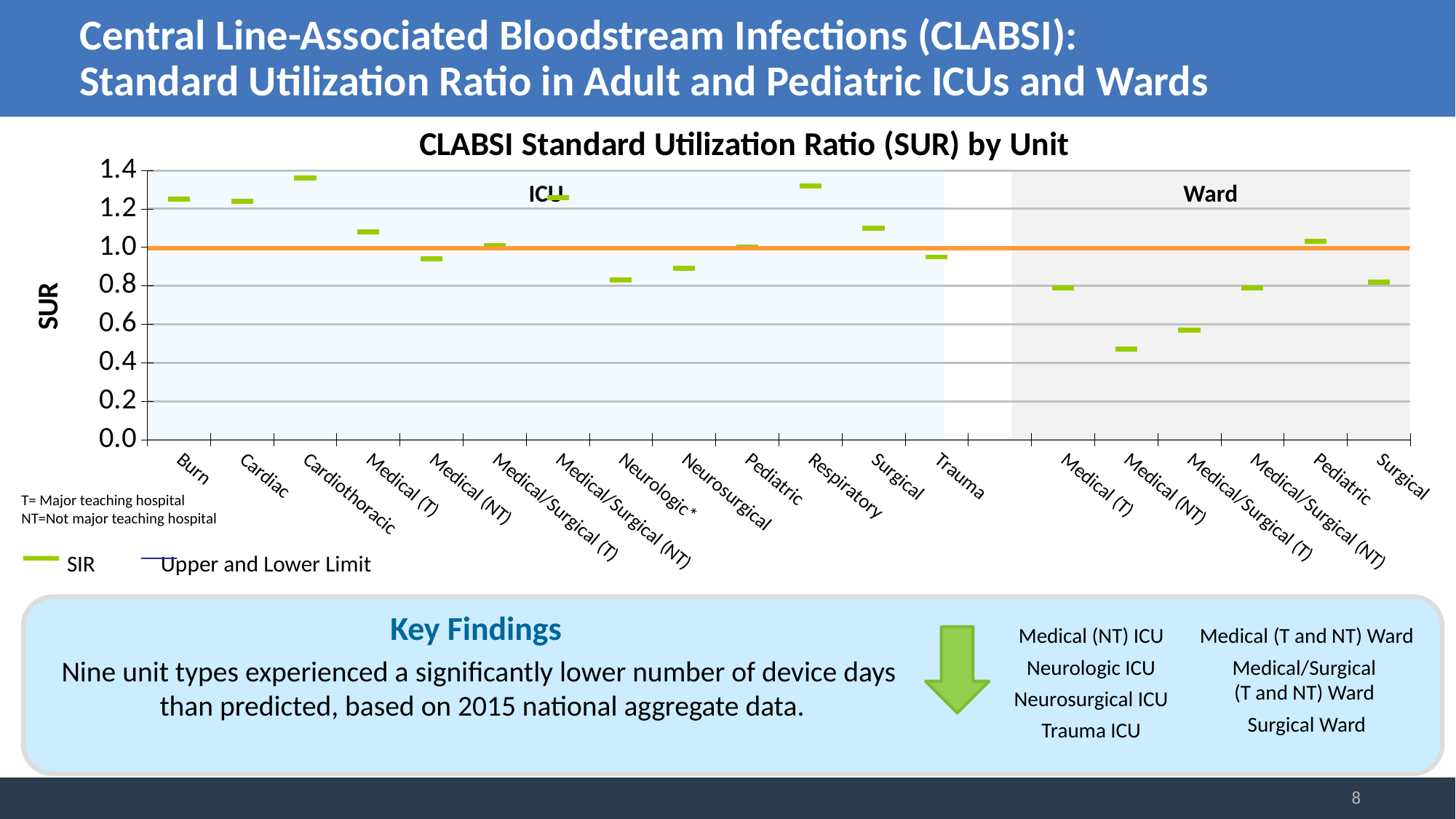
Is the SUR value for the Medical (NT) Ward greater or less than 0.6? less How many unit categories are plotted along the x axis of the chart? 19 How many units are plotted in the Ward section of the chart? 6 How many units are plotted in the ICU section of the chart? 13 What is the title of the chart? CLABSI Standard Utilization Ratio (SUR) by Unit Which unit has the lowest SUR value in the chart? Medical (NT) Ward Is the SUR value for the Respiratory ICU greater or less than 1.2? greater Which has a higher SUR value: the Medical (NT) Ward or the Pediatric Ward? Pediatric Ward At what SUR value is the horizontal orange reference line drawn on the chart? 1.0 Is the SUR value for the Cardiothoracic ICU greater or less than 1.2? greater Which has a higher SUR value: the Cardiothoracic ICU or the Neurologic ICU? Cardiothoracic ICU